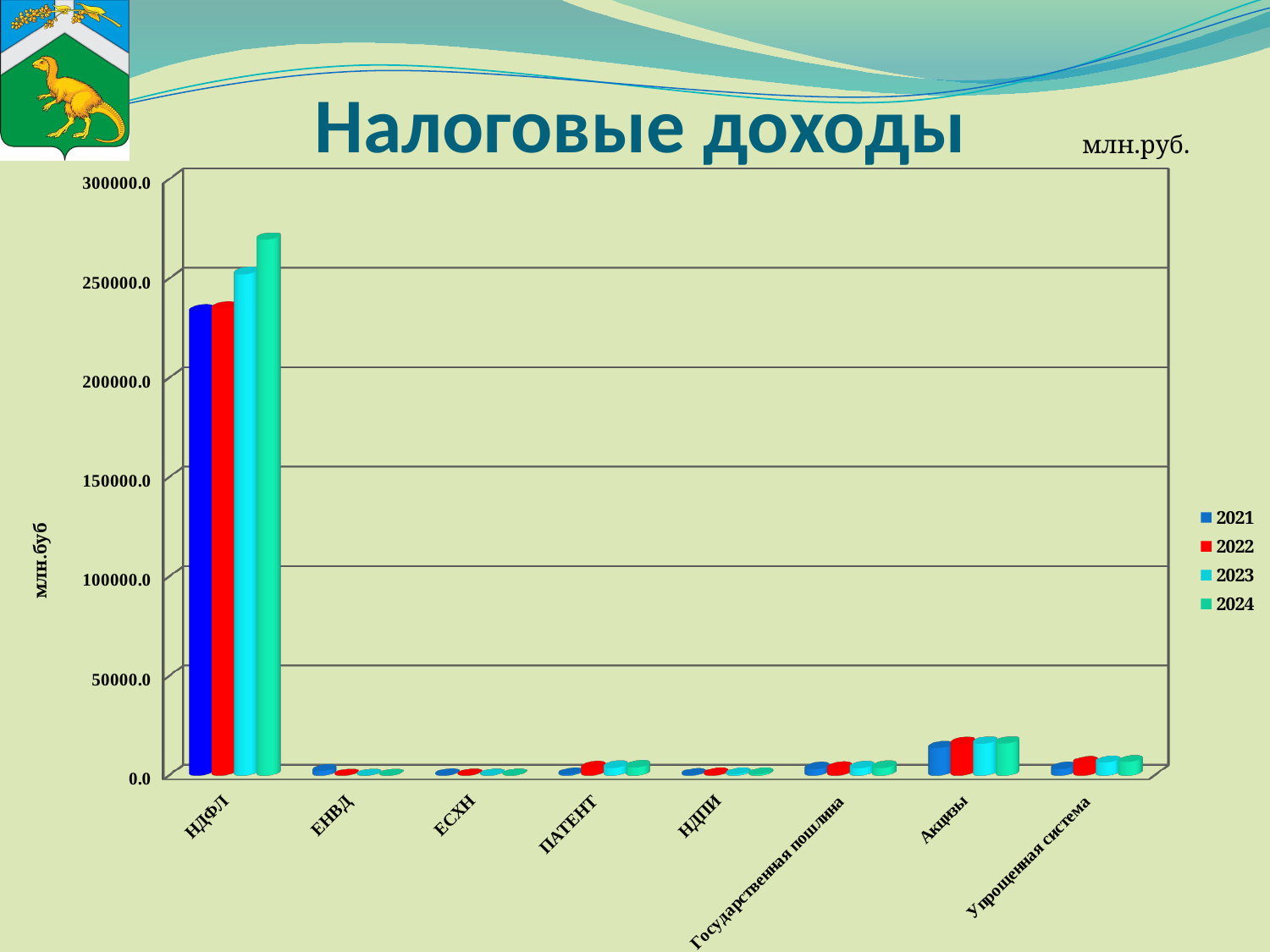
Is the value for НДФЛ in 2024 greater or less than 250000.0? greater Which year is shown in red in the legend? 2022 How many series does the legend list? 4 Which is larger for НДФЛ: the 2021 value or the 2024 value? 2024 Is the value for Акцизы in 2022 greater or less than 50000.0? less What is the title of the chart? Налоговые доходы For НДФЛ, which year has the highest bar? 2024 Is the value for НДФЛ in 2021 greater or less than 250000.0? less What type of chart is shown on the slide? bar chart Which category has the highest values in the chart? НДФЛ Do the values for НДФЛ rise or fall from 2021 to 2024? rise How many categories are shown on the x axis? 8